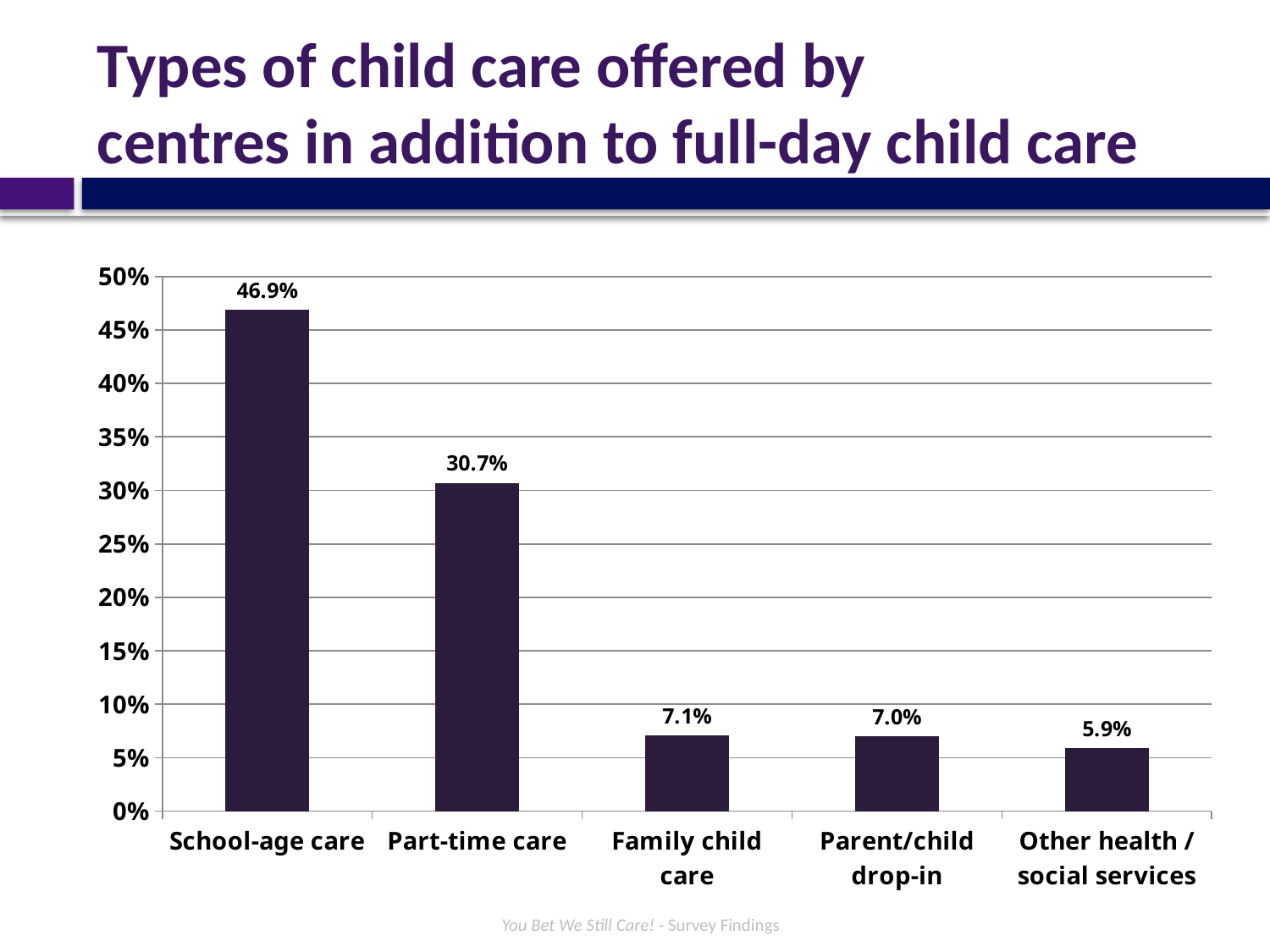
How many types of child care are shown on the chart? 5 What percentage is shown for Other health / social services? 5.9% Which type of child care has the lowest value? Other health / social services What percentage of centres offer school-age care? 46.9% What is the value shown for Part-time care? 30.7% What is the title of the slide? Types of child care offered by centres in addition to full-day child care What kind of chart is shown on the slide? Bar chart What is the difference between the values for Family child care and Other health / social services? 1.2% Is the value for Parent/child drop-in greater or less than 10%? less Which type of child care has the highest value? School-age care Which is larger, the value for Part-time care or the value for Family child care? Part-time care What is the difference between the values for School-age care and Part-time care? 16.2%